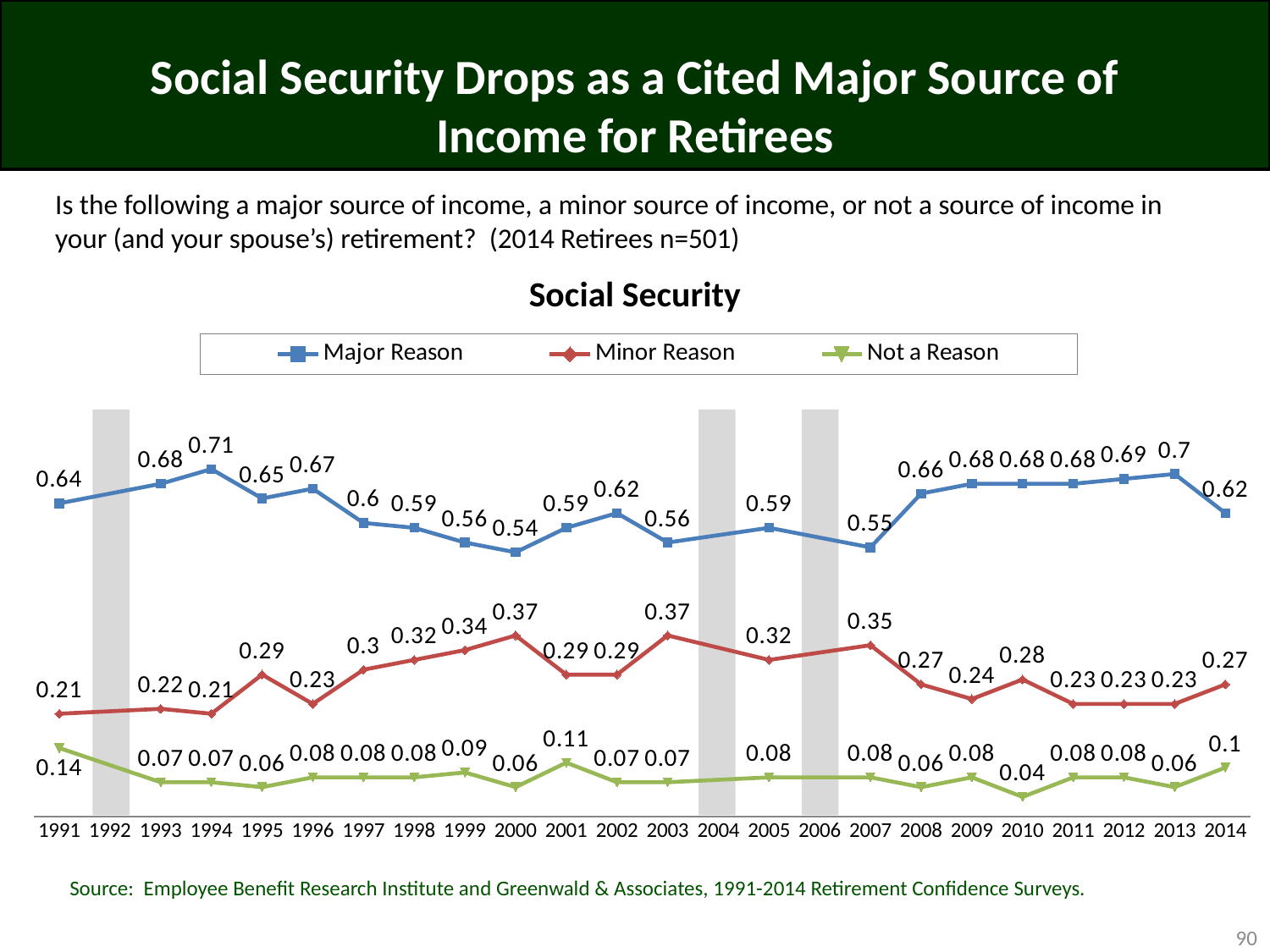
Does the Major Reason series rise or fall from 2013 to 2014? fall What is the value for Not a Reason in 1991? 0.14 Which is larger, the Minor Reason value in 2007 or in 2008? 2007 In which year does the Major Reason series reach its highest value? 1994 What type of chart is shown on the slide? line chart How many series does the legend list? 3 What is the value for Major Reason in 2014? 0.62 In which year does the Major Reason series reach its lowest value? 2000 What is the value for Minor Reason in 2000? 0.37 In which year does the Not a Reason series reach its lowest value? 2010 What is the difference between the Major Reason values in 2013 and 2014? 0.08 What is the title of the chart? Social Security